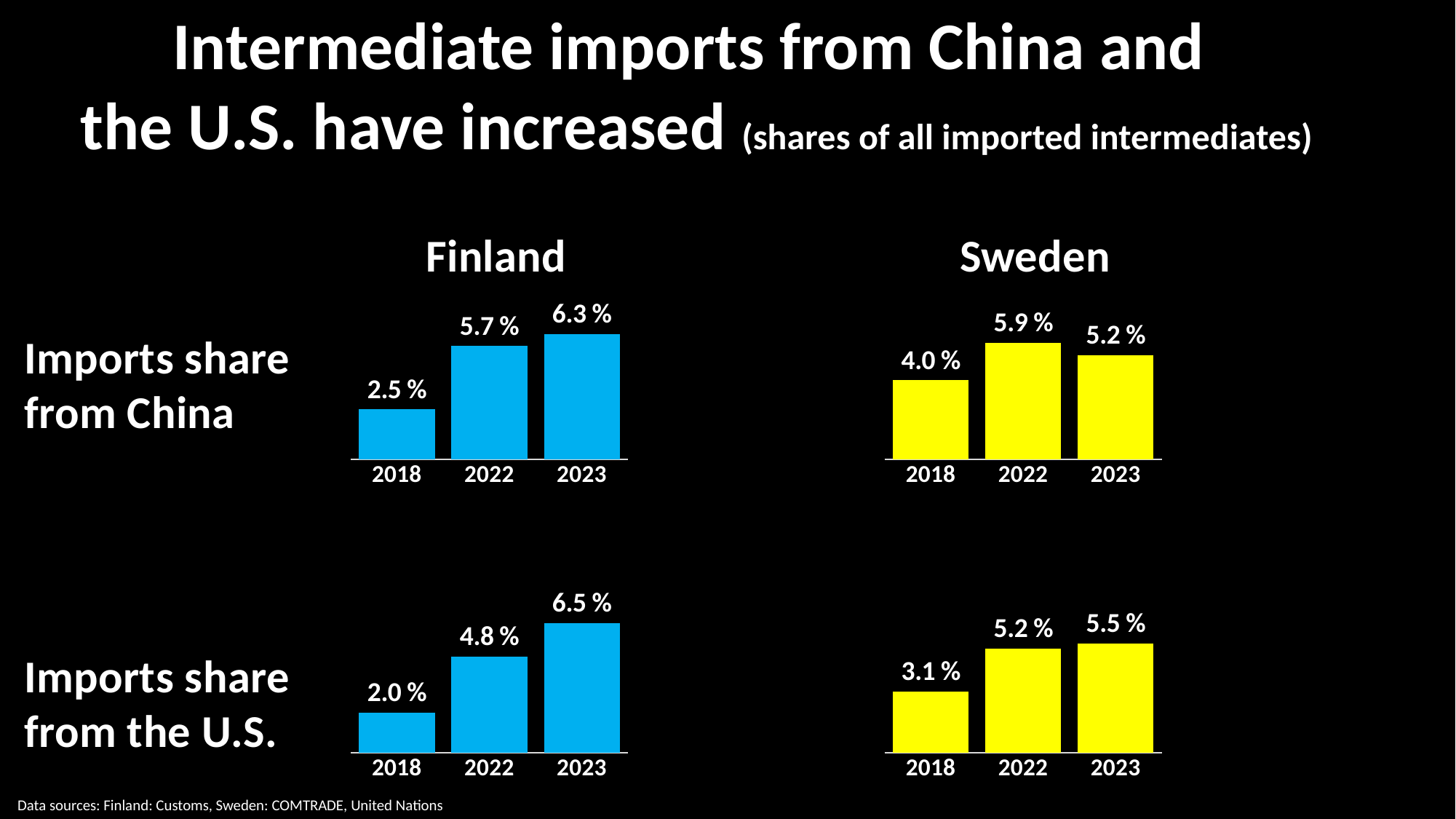
In the Finland imports share from China chart, what is the value for 2018? 2.5 % In the Finland imports share from the U.S. chart, what is the value for 2023? 6.5 % In the Finland imports share from China chart, what is the difference between the 2023 and 2018 values? 3.8 % How many years are shown in the Finland imports share from China chart? 3 In the Finland imports share from the U.S. chart, do the values rise or fall from 2018 to 2023? Rise In the Sweden imports share from China chart, which is larger, the value for 2022 or the value for 2023? 2022 In the Finland imports share from the U.S. chart, which year has the lowest value? 2018 In the Sweden imports share from China chart, what is the value for 2022? 5.9 % What kind of chart is the Sweden imports share from the U.S. chart? Bar chart In the Sweden imports share from the U.S. chart, what is the difference between the 2023 and 2022 values? 0.3 % In the Sweden imports share from the U.S. chart, what is the value for 2018? 3.1 % In the Sweden imports share from China chart, which year has the highest value? 2022